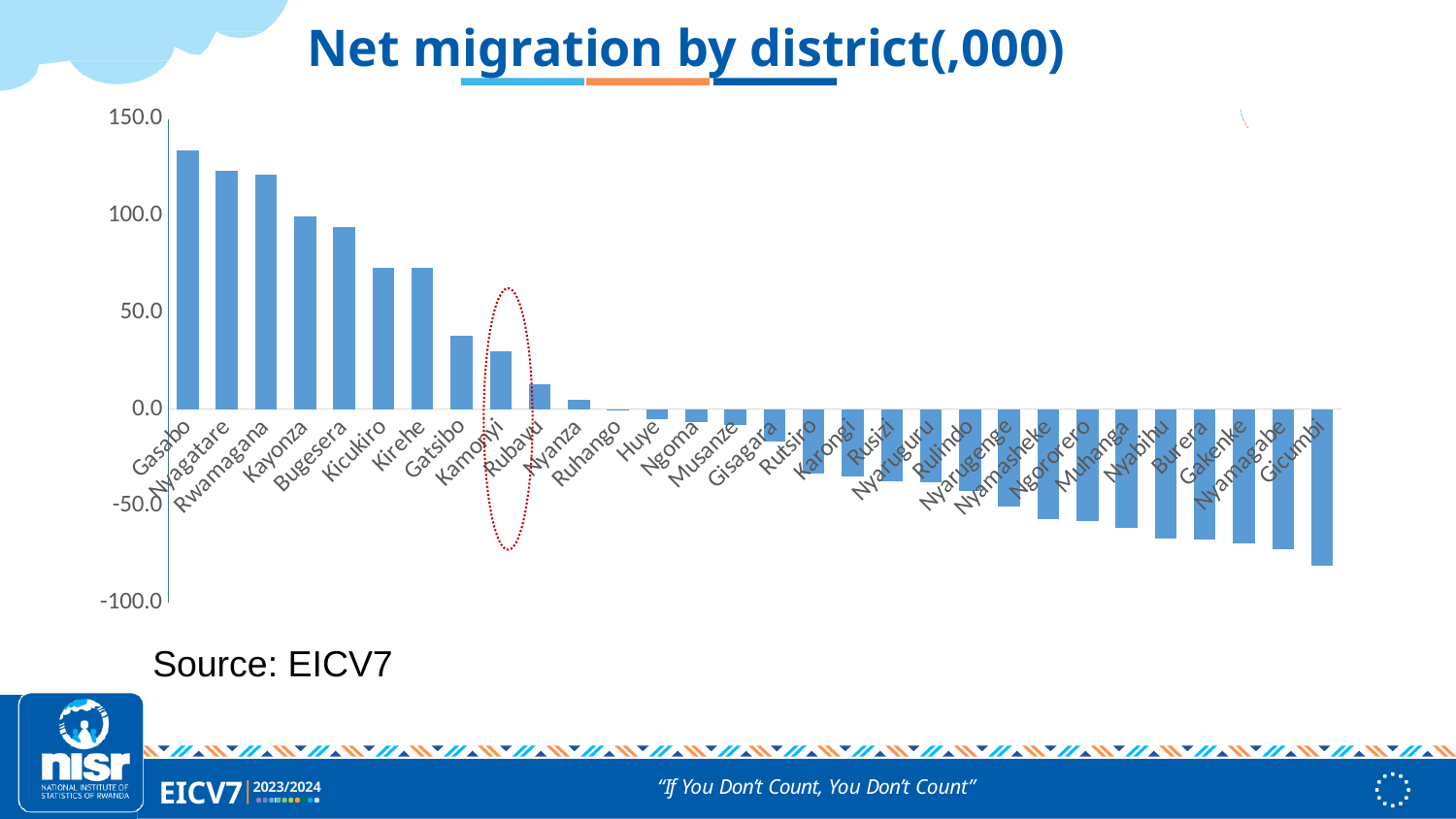
Which district has the lowest net migration? Gicumbi Is the value for Bugesera greater or less than 100.0? less Is the value for Gatsibo greater or less than 50.0? less What kind of chart is shown on the slide? Bar chart Is the value for Gicumbi greater or less than -50.0? less Which district has the highest net migration? Gasabo Which has the larger net migration, Gasabo or Nyagatare? Gasabo What is the title of the chart? Net migration by district(,000) Do the values rise or fall moving from left to right along the x axis? Fall How many districts are plotted on the chart? 30